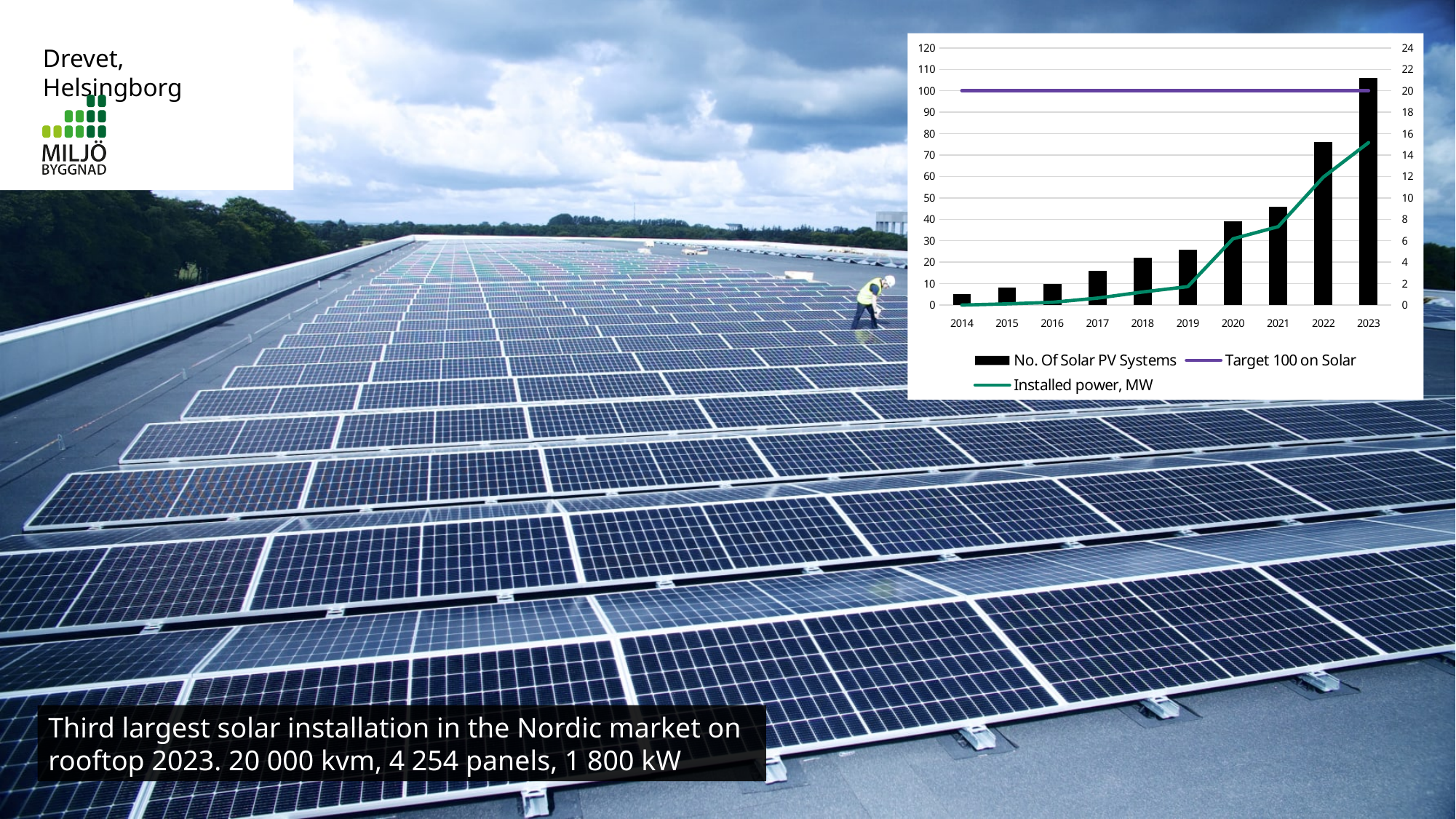
How many years are shown on the x axis of the chart? 10 What kind of chart is shown on the slide? A combined bar and line chart How many series does the chart legend list? 3 Does the installed power in MW rise or fall from 2014 to 2023? Rises Which series in the chart is drawn as a purple line? Target 100 on Solar Is the number of solar PV systems in 2023 greater or less than 100? greater Is the number of solar PV systems in 2022 greater or less than 80? less Is the number of solar PV systems in 2014 greater or less than 10? less Which year has the lowest number of solar PV systems? 2014 Which year has the highest number of solar PV systems? 2023 At what value does the 'Target 100 on Solar' line sit on the left axis? 100 Which is larger, the number of solar PV systems in 2022 or in 2021? 2022